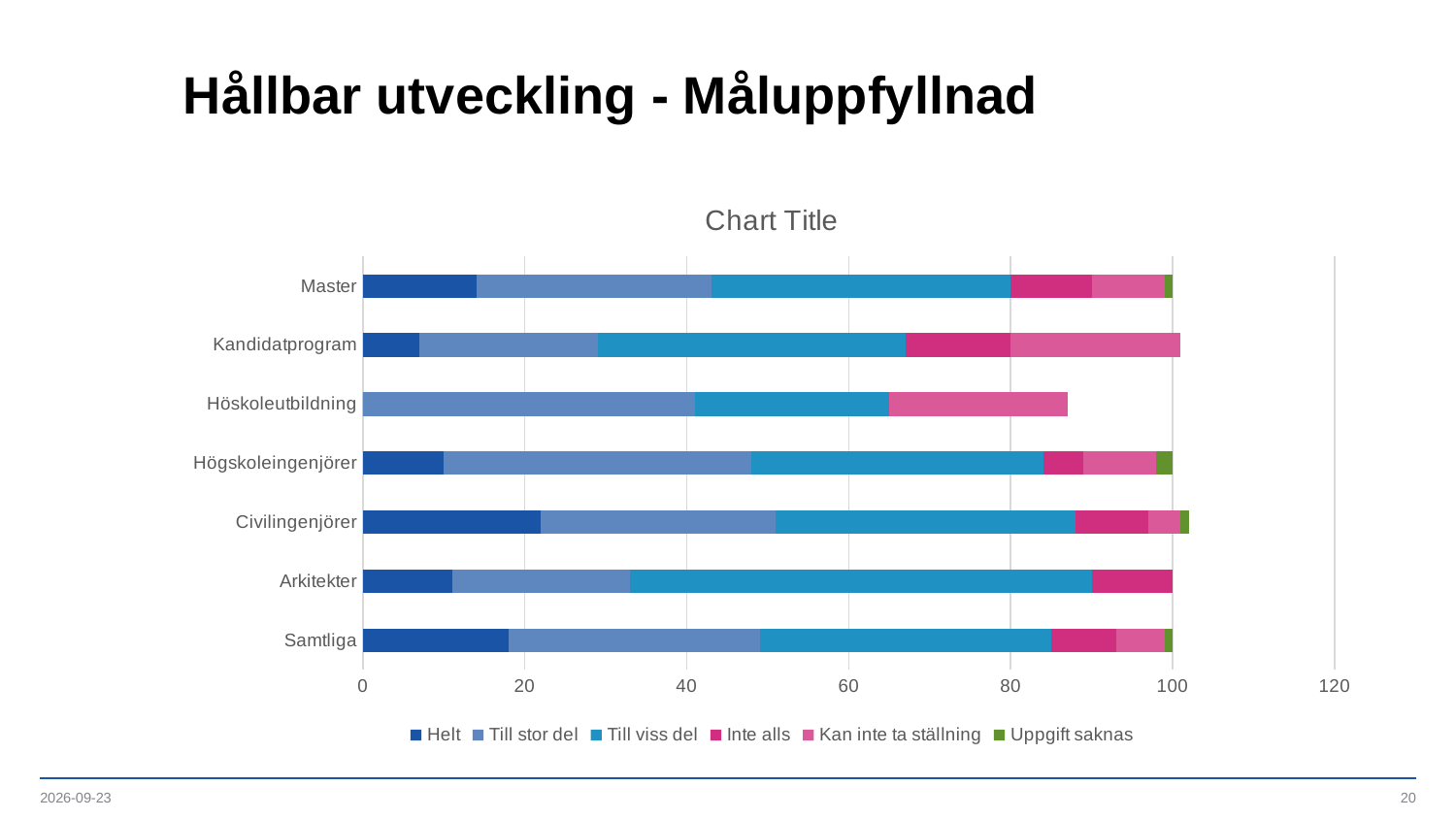
Which category has the largest 'Helt' segment? Civilingenjörer Is the 'Helt' value for Kandidatprogram greater or less than 20? less What kind of chart is shown on the slide? Stacked bar chart Which category has the shortest total stacked bar? Höskoleutbildning Is the total stacked bar for Höskoleutbildning greater or less than 100? less What is the title shown above the chart? Chart Title Is the 'Helt' value for Master greater or less than 20? less How many series does the chart legend list? 6 Which has the larger 'Helt' segment, Civilingenjörer or Kandidatprogram? Civilingenjörer How many categories are shown on the vertical axis of the chart? 7 What is the first series listed in the chart legend? Helt